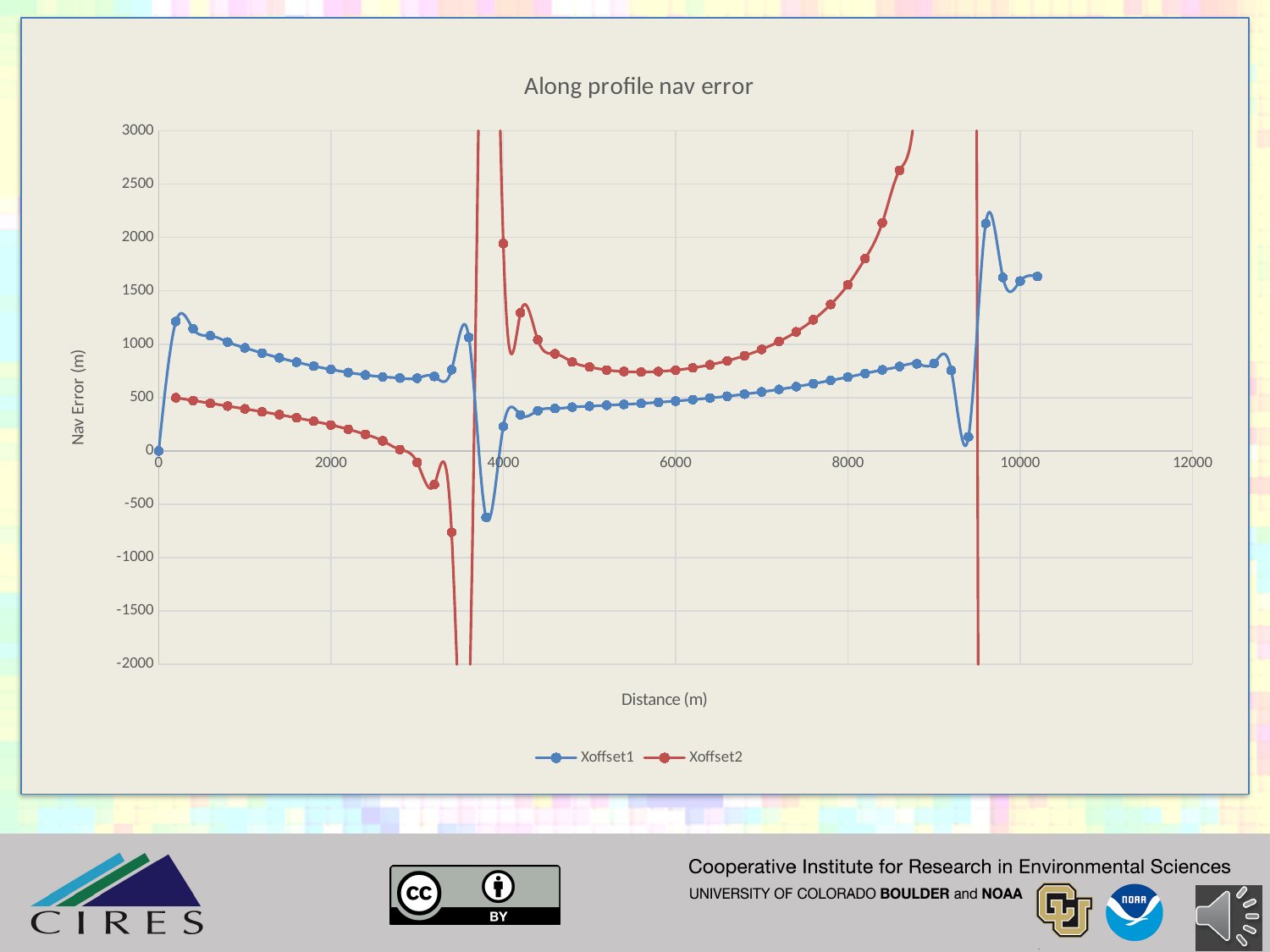
Is the value of Xoffset1 at a distance of 2000 greater or less than 500? greater Is the value of Xoffset2 at a distance of 2000 greater or less than 500? less Between distances of 6000 and 8000, does the Xoffset2 series rise or fall? rise What kind of chart is shown on the slide? line chart Is the value of Xoffset1 at a distance of 10000 greater or less than 1000? greater What is the label of the y axis? Nav Error (m) Between distances of 500 and 2500, does the Xoffset1 series rise or fall? fall At a distance of 2000, which series has the larger value, Xoffset1 or Xoffset2? Xoffset1 What is the title of the chart? Along profile nav error At a distance of 8000, which series has the larger value, Xoffset1 or Xoffset2? Xoffset2 How many series does the legend list? 2